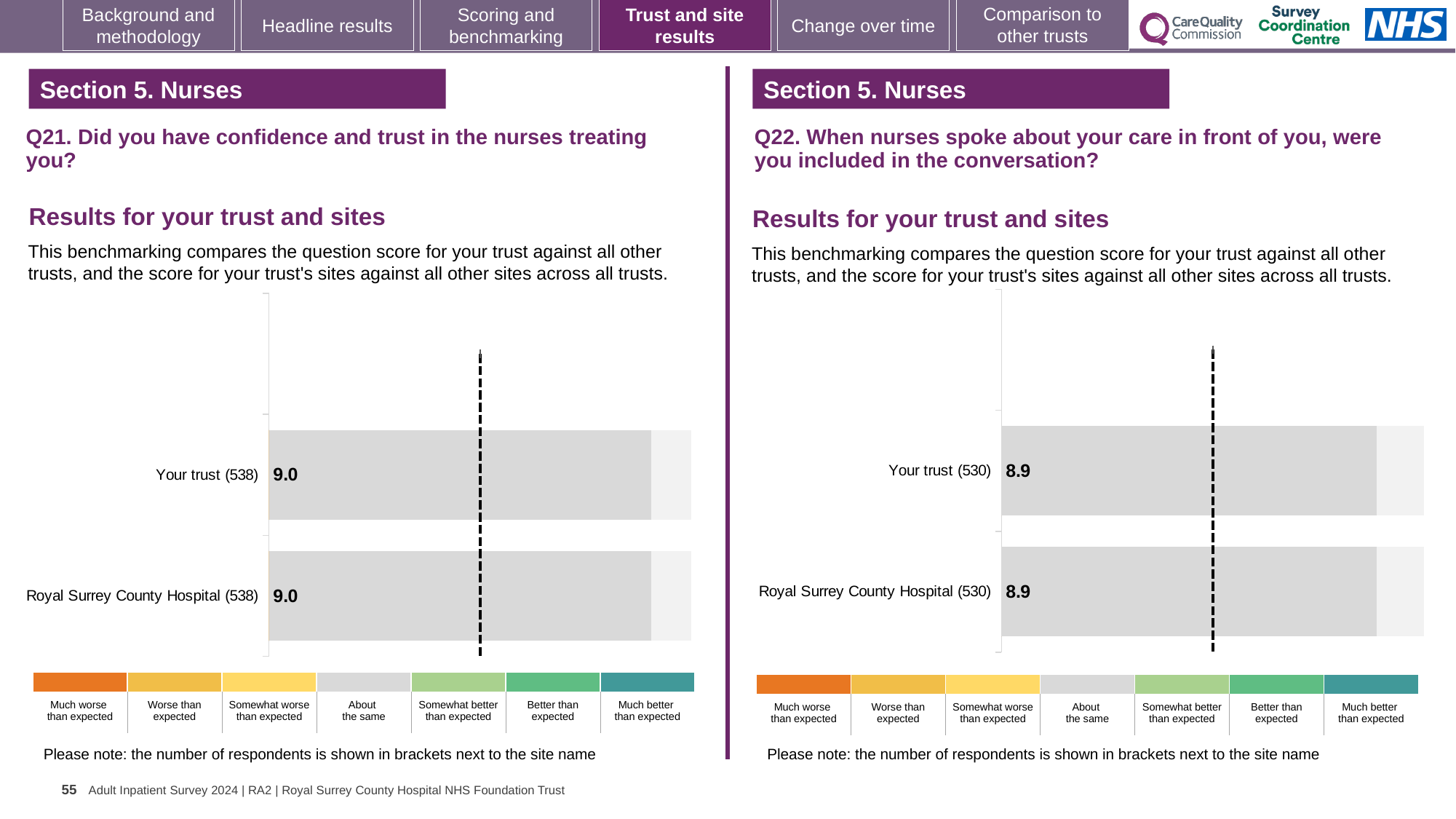
On the Q21 chart (left), what is the difference between the score for Your trust and the score for Royal Surrey County Hospital? 0.0 How many bars are plotted on the Q21 chart (left)? 2 On the Q22 chart (right), how many respondents are shown in brackets next to Royal Surrey County Hospital? 530 On the Q22 chart (right), what is the score for Your trust? 8.9 On the Q21 chart (left), how many respondents are shown in brackets next to Your trust? 538 On the Q21 chart (left), what is the score for Royal Surrey County Hospital? 9.0 On the Q22 chart (right), what is the difference between the score for Your trust and the score for Royal Surrey County Hospital? 0.0 How many bars are plotted on the Q22 chart (right)? 2 What type of chart is used on the Q21 chart (left)? Bar chart Is the score for Your trust on the Q22 chart (right) greater or less than the score for Your trust on the Q21 chart (left)? less On the Q21 chart (left), what is the score for Your trust? 9.0 On the Q22 chart (right), what is the score for Royal Surrey County Hospital? 8.9